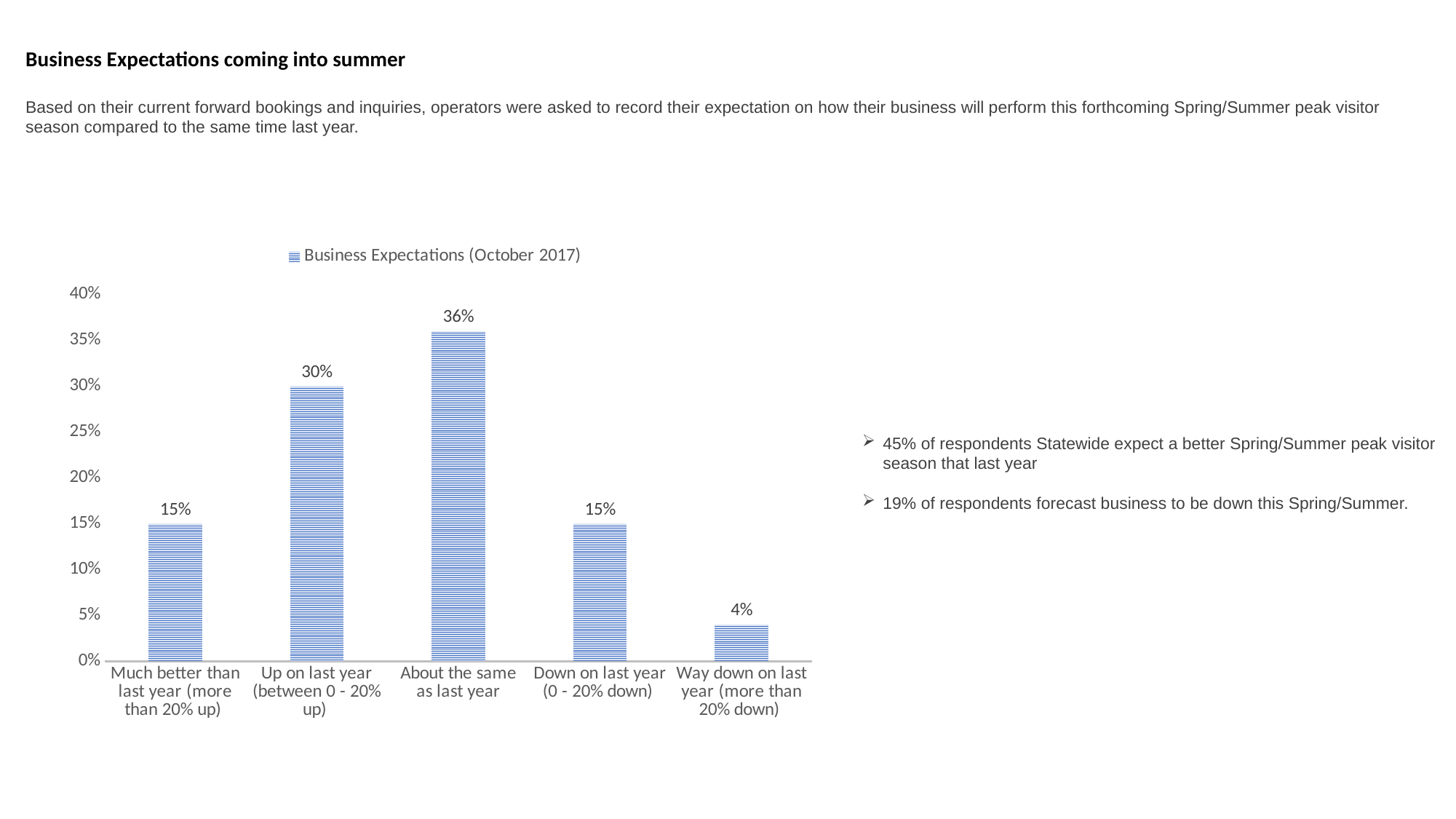
Which is larger: 'Much better than last year (more than 20% up)' or 'Up on last year (between 0 - 20% up)'? Up on last year (between 0 - 20% up) What percentage of operators expect business to be 'About the same as last year'? 36% What is the value for 'Up on last year (between 0 - 20% up)'? 30% What series name does the legend show? Business Expectations (October 2017) Which category has the lowest value? Way down on last year (more than 20% down) What kind of chart is shown on the slide? Bar chart What is the value for 'Way down on last year (more than 20% down)'? 4% How many categories are shown on the x axis? 5 What is the difference between 'Down on last year (0 - 20% down)' and 'Way down on last year (more than 20% down)'? 11% What is the difference between 'About the same as last year' and 'Up on last year (between 0 - 20% up)'? 6% Which category has the highest value? About the same as last year Is the value for 'About the same as last year' greater or less than 35%? greater